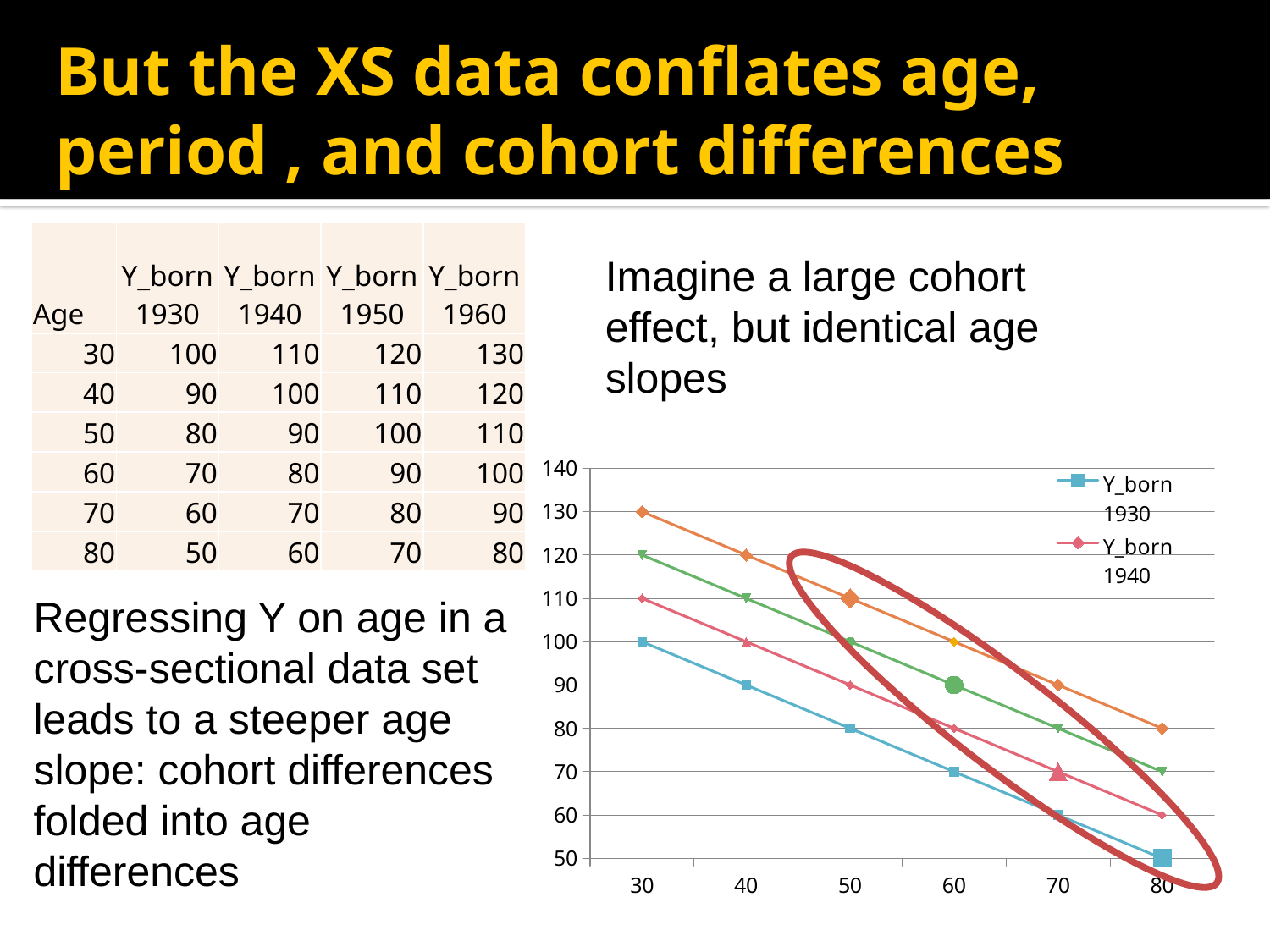
What is the value of the Y_born 1930 line at age 80? 50 What kind of chart is shown on the slide? line chart Do the values of the Y_born 1930 line rise or fall as age increases? fall What is the value of the Y_born 1940 line at age 80? 60 How many lines are plotted on the chart? 4 How many age values are shown along the x axis of the chart? 6 Is the value of the Y_born 1930 line at age 60 greater or less than 100? less What is the value of the Y_born 1930 line at age 30? 100 At which age does the Y_born 1930 line reach its highest value? 30 At age 50, which line has the higher value, Y_born 1930 or Y_born 1940? Y_born 1940 At which age does the Y_born 1940 line reach its lowest value? 80 What is the difference between the Y_born 1940 and Y_born 1930 values at age 30? 10